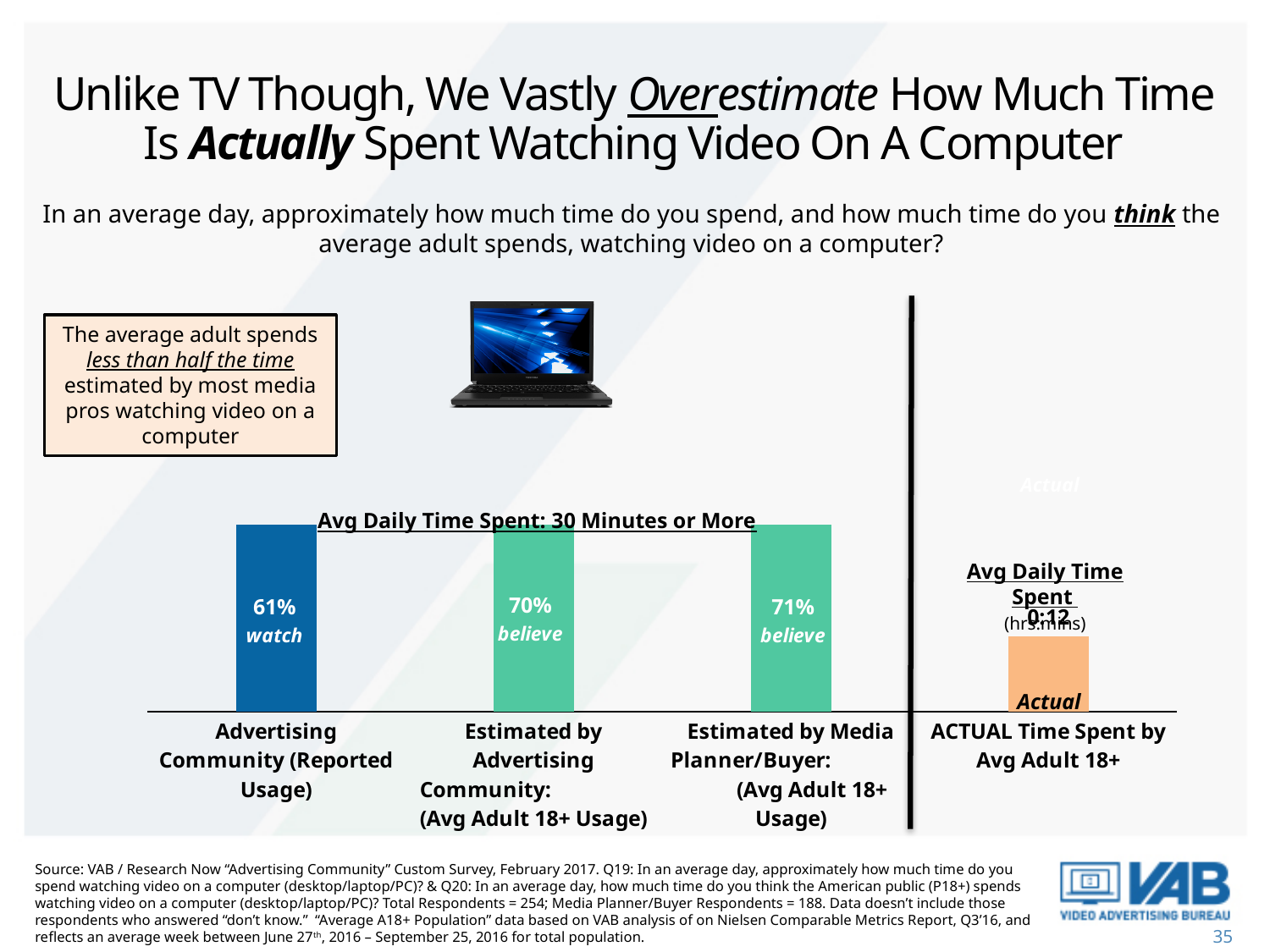
What percentage of the Advertising Community believe the average adult 18+ spends 30 minutes or more per day watching video on a computer? 70% How many percentage bars are shown in the 'Avg Daily Time Spent: 30 Minutes or More' chart? 3 What is the difference in percentage points between the Advertising Community's estimate for adults 18+ and its own reported usage? 9 What is the difference in percentage points between the Media Planner/Buyer estimate and the Advertising Community's reported usage? 10 Which is larger: the percentage estimated by the Advertising Community or the percentage estimated by Media Planners/Buyers? Estimated by Media Planner/Buyer What is the actual average daily time spent watching video on a computer by the average adult 18+, as shown on the slide? 0:12 What type of chart is used to show the 'Avg Daily Time Spent: 30 Minutes or More' data? Bar chart What percentage of Media Planners/Buyers believe the average adult 18+ spends 30 minutes or more per day watching video on a computer? 71% What percentage of the Advertising Community reported watching video on a computer for 30 minutes or more per day? 61% What is the title of the chart showing the three percentage bars? Avg Daily Time Spent: 30 Minutes or More Which category has the lowest percentage in the 'Avg Daily Time Spent: 30 Minutes or More' chart? Advertising Community (Reported Usage) Which category has the highest percentage in the 'Avg Daily Time Spent: 30 Minutes or More' chart? Estimated by Media Planner/Buyer: (Avg Adult 18+ Usage)